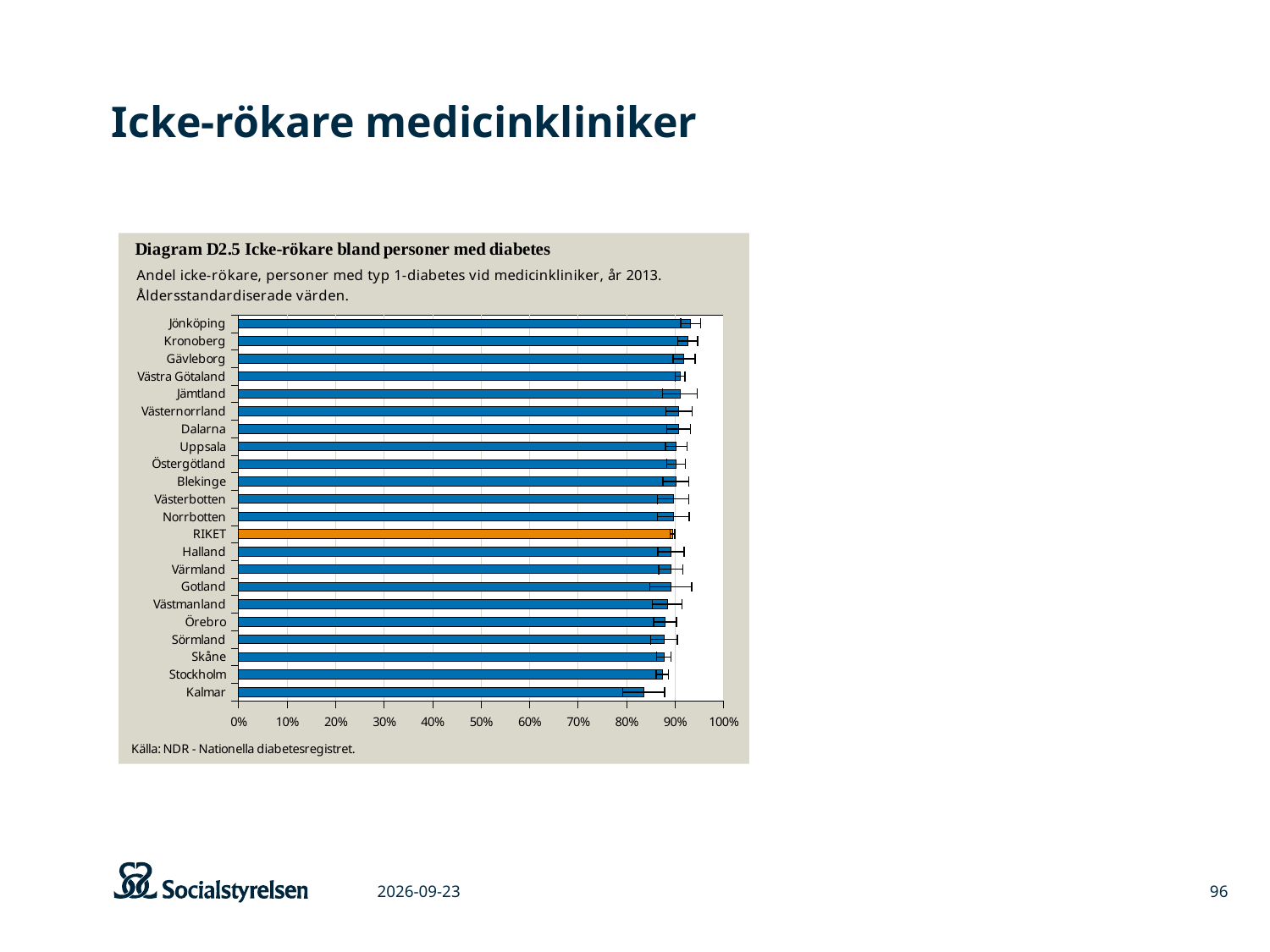
Is the value for Jönköping greater or less than 90%? greater What kind of chart is shown on the slide? bar chart Which bar in the chart is coloured orange instead of blue? RIKET Which has the larger value, Jönköping or Kalmar? Jönköping How many categories (bars) are shown in the chart? 22 Which category has the lowest share of non-smokers in the chart? Kalmar Is the value for Kalmar greater or less than 90%? less What is the source given below the chart? NDR - Nationella diabetesregistret Which category has the highest share of non-smokers in the chart? Jönköping Which has the larger value, Kronoberg or Stockholm? Kronoberg Is the value for Kalmar greater or less than 80%? greater